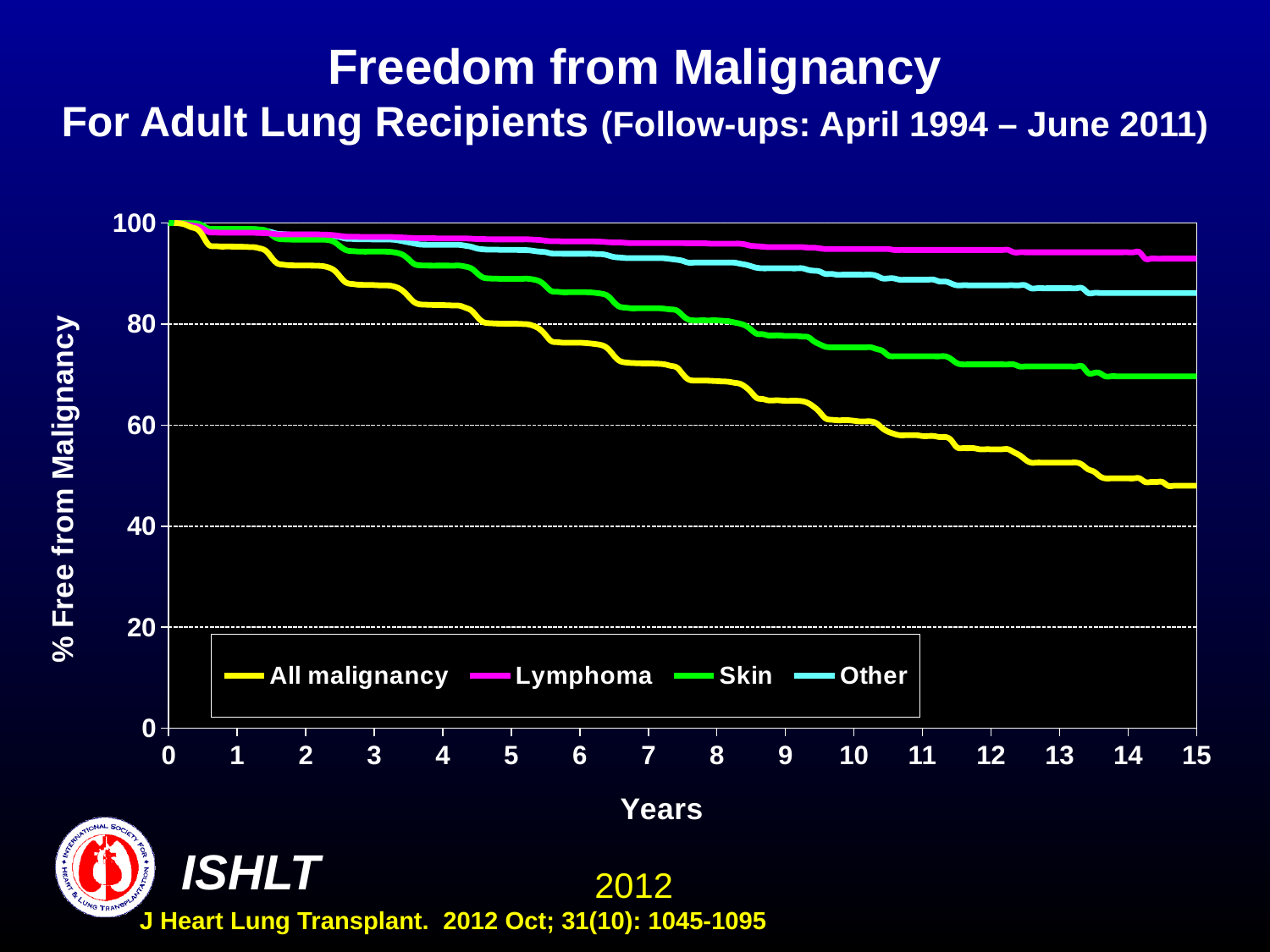
Which series has the highest value at 15 years? Lymphoma What is the label of the y axis? % Free from Malignancy What is the maximum value shown on the x axis? 15 Do the values for All malignancy rise or fall as years increase? fall Which series has the lowest value at 15 years? All malignancy At 15 years, which is larger: the value for Lymphoma or the value for Skin? Lymphoma Is the value for Skin at 15 years greater or less than 60? greater Is the value for Lymphoma at 15 years greater or less than 80? greater Is the value for Skin at 10 years greater or less than 80? less How many series does the legend list? 4 What kind of chart is shown on the slide? line chart